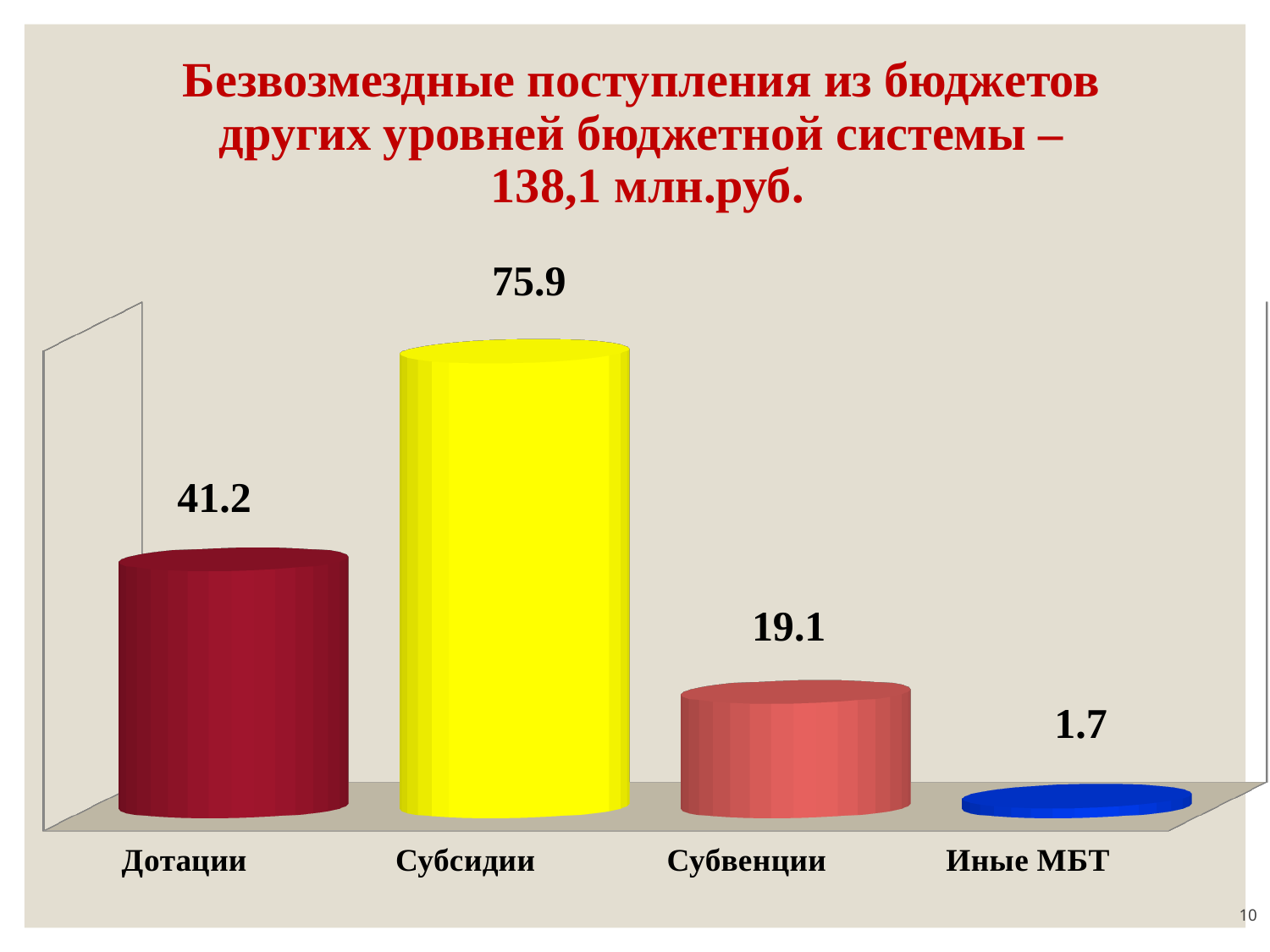
What is the value for Иные МБТ? 1.7 What total amount in million rubles is stated in the chart title? 138,1 млн.руб. Which category has the highest value? Субсидии What is the value for Субсидии? 75.9 What is the difference between the values for Субвенции and Иные МБТ? 17.4 Which is larger, the value for Дотации or the value for Субвенции? Дотации Which category has the lowest value? Иные МБТ What is the value for Дотации? 41.2 How many categories are shown in the chart? 4 What is the difference between the values for Субсидии and Дотации? 34.7 What kind of chart is shown on the slide? Bar chart What is the value for Субвенции? 19.1